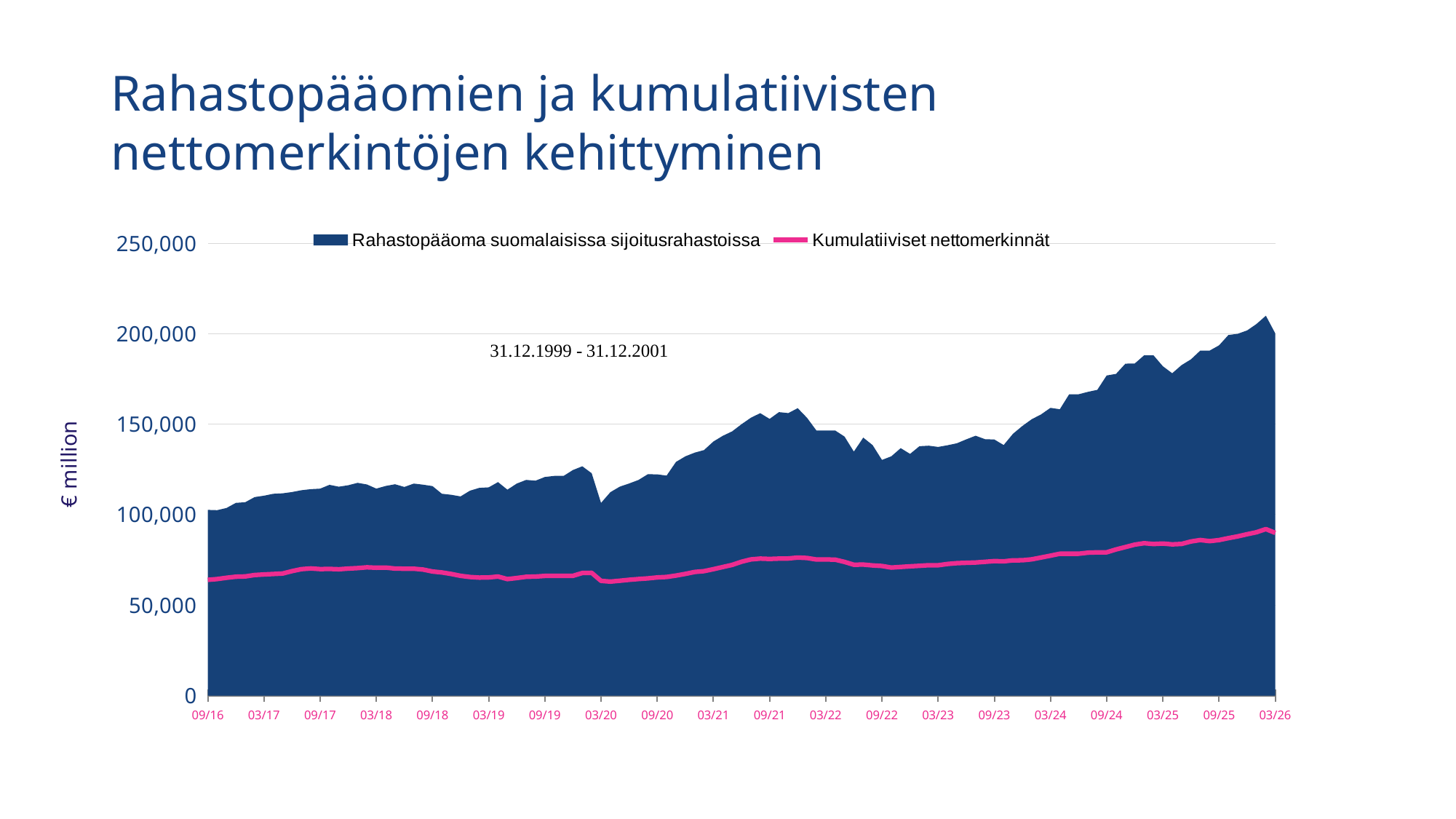
Is the value of Rahastopääoma suomalaisissa sijoitusrahastoissa at 09/24 greater or less than 150,000? greater Is the value of Kumulatiiviset nettomerkinnät at 09/16 greater or less than 50,000? greater What kind of chart is shown on the slide? Area chart with a line What unit is shown on the y-axis label? € million What are the two series named in the legend? Rahastopääoma suomalaisissa sijoitusrahastoissa; Kumulatiiviset nettomerkinnät How many series does the legend list? 2 Does the value of Rahastopääoma suomalaisissa sijoitusrahastoissa overall rise or fall from 09/16 to 03/26? rise At which x-axis label does Kumulatiiviset nettomerkinnät reach its highest value? 03/26 Is the value of Kumulatiiviset nettomerkinnät at 03/26 greater or less than 100,000? less Which series has the larger value at 03/24, Rahastopääoma suomalaisissa sijoitusrahastoissa or Kumulatiiviset nettomerkinnät? Rahastopääoma suomalaisissa sijoitusrahastoissa How many x-axis labels are shown on the chart? 20